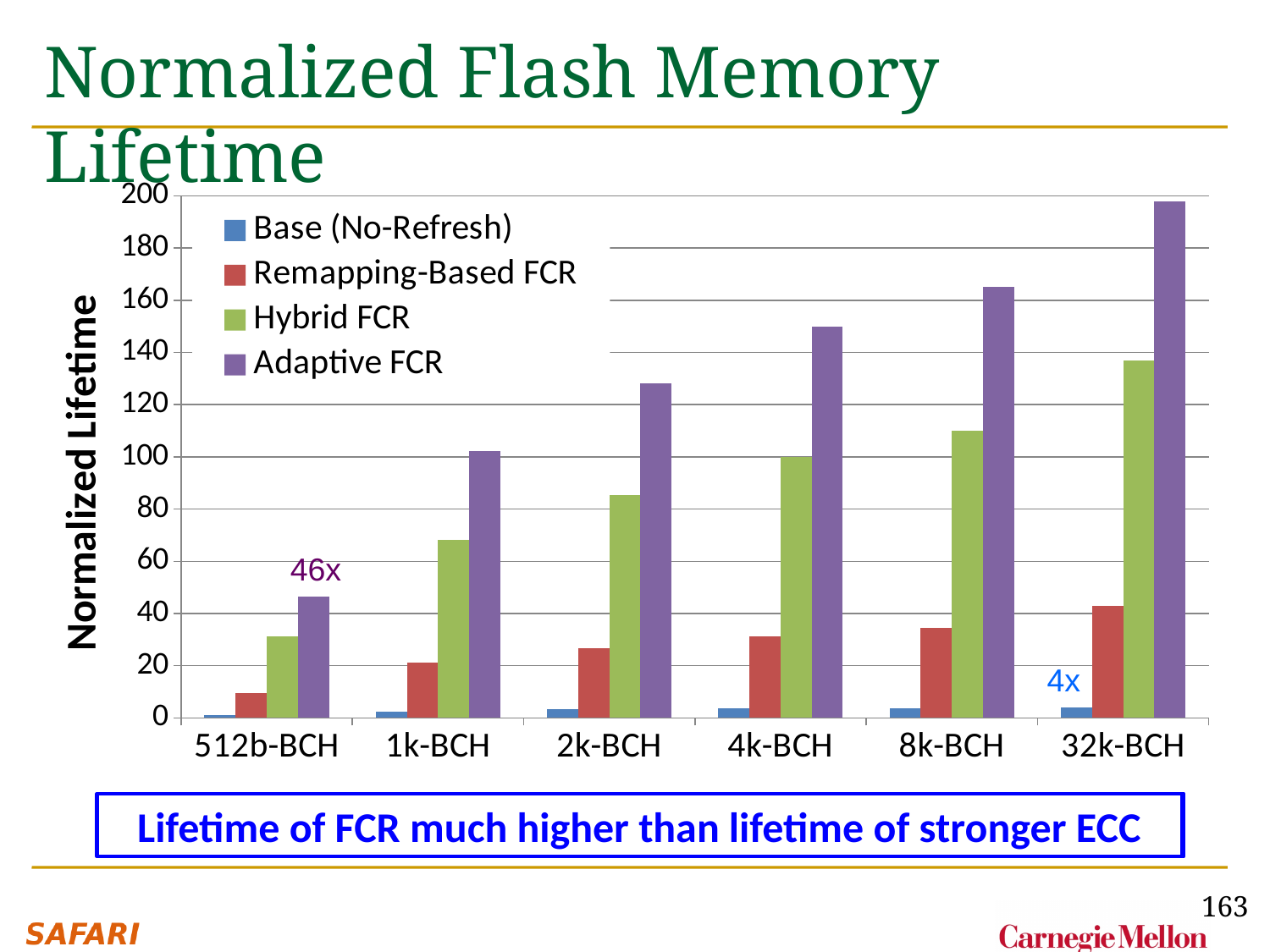
How many series does the legend list? 4 For 2k-BCH, which is larger: Hybrid FCR or Remapping-Based FCR? Hybrid FCR Which category has the lowest Adaptive FCR value? 512b-BCH Is the Adaptive FCR value for 4k-BCH greater or less than 140? greater Which category has the highest Adaptive FCR value? 32k-BCH Is the Remapping-Based FCR value for 32k-BCH greater or less than 60? less What is the first entry in the legend? Base (No-Refresh) What kind of chart is shown on the slide? bar chart Is the Hybrid FCR value for 1k-BCH greater or less than 60? greater How many categories are shown on the x axis? 6 What is the label of the y axis? Normalized Lifetime Do the Adaptive FCR values rise or fall from 512b-BCH to 32k-BCH? rise